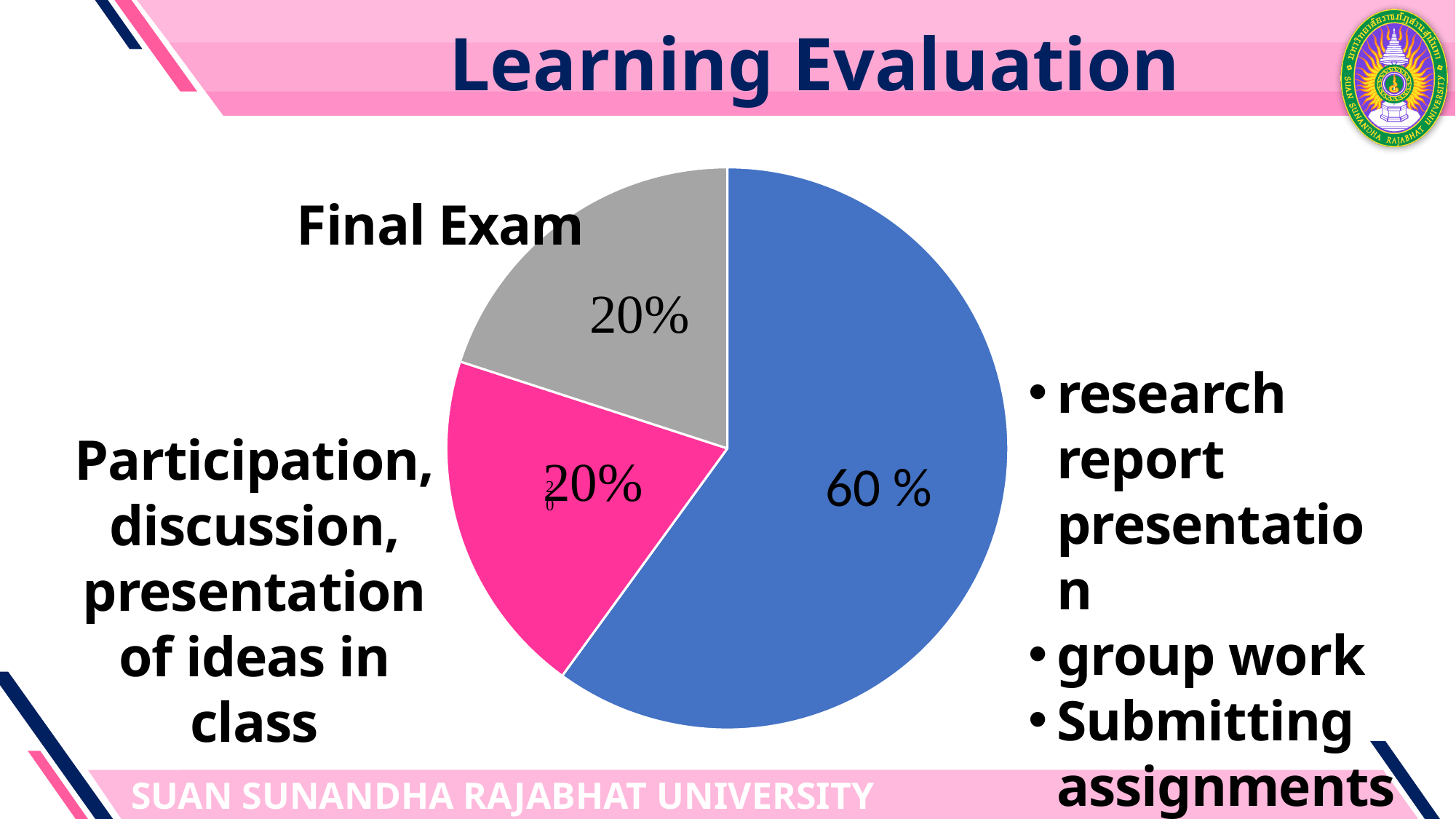
Which slice of the pie chart is the largest? the blue slice (60 %) Which is larger, the Final Exam slice or the blue slice? the blue slice What percentage is shown on the blue slice of the pie chart? 60 % What is the difference between the blue slice's percentage and the Final Exam percentage? 40% What is the title of the slide containing the pie chart? Learning Evaluation How many slices does the pie chart have? 3 What share of the pie does the Final Exam slice represent? 20% What percentage does the Final Exam slice show? 20% What colour is the Final Exam slice? gray What percentage is shown for Participation, discussion, presentation of ideas in class? 20% What kind of chart is shown on the slide? pie chart What is the combined percentage of the Final Exam slice and the Participation, discussion, presentation of ideas in class slice? 40%